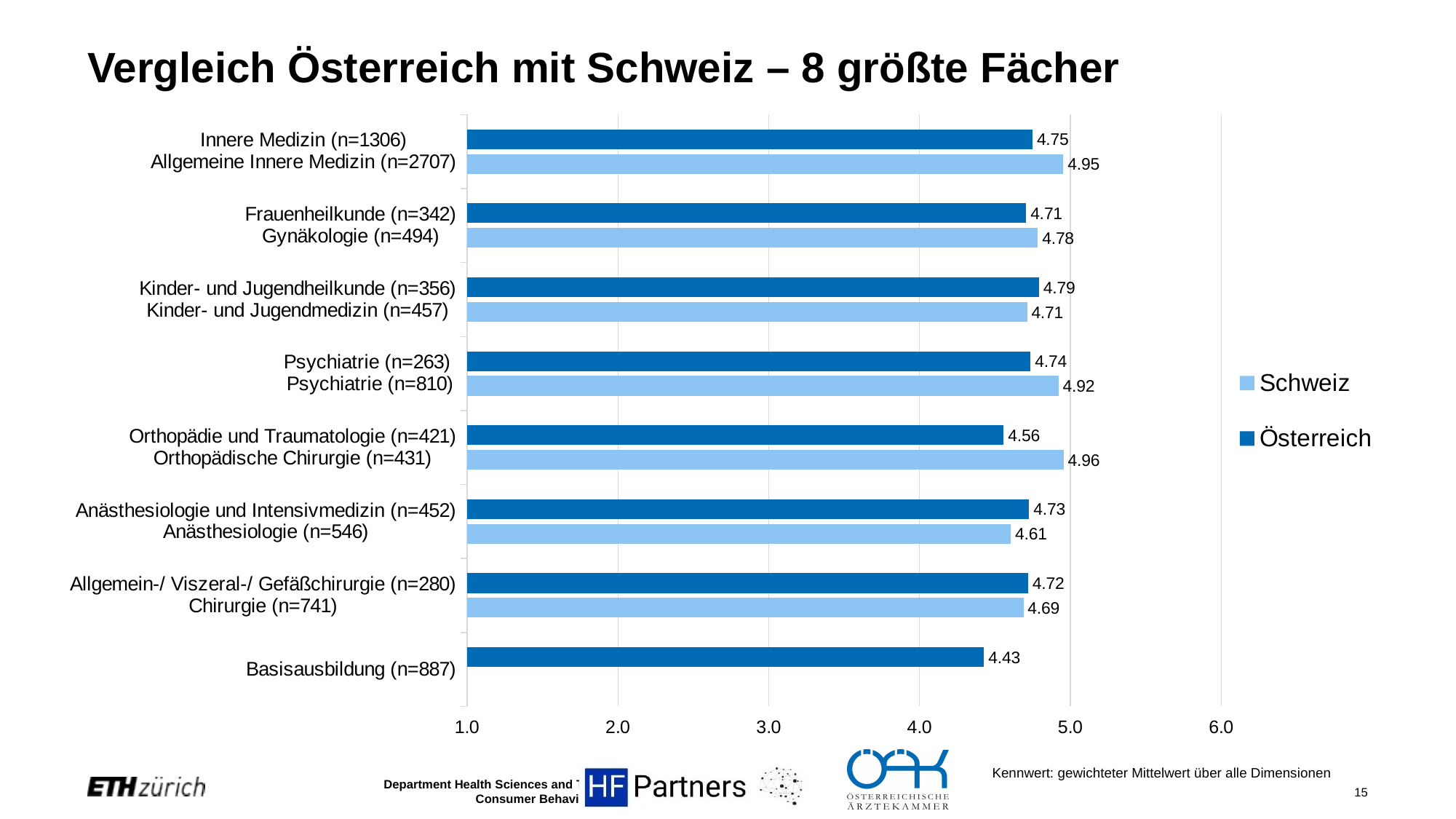
What is the value for Basisausbildung (n=887)? 4.43 Which Österreich category has the lowest value? Basisausbildung (n=887) What kind of chart is shown on the slide? Bar chart What is the value for Psychiatrie (n=810) for Schweiz? 4.92 What is the value for Innere Medizin (n=1306) for Österreich? 4.75 Which colour represents Schweiz in the legend? Light blue How many series does the legend list? 2 What is the value for Orthopädische Chirurgie (n=431) for Schweiz? 4.96 Is the value for Basisausbildung (n=887) greater or less than 5.0? less Which Schweiz category has the highest value? Orthopädische Chirurgie (n=431) Which is larger: the Österreich value for Anästhesiologie und Intensivmedizin (n=452) or the Schweiz value for Anästhesiologie (n=546)? Anästhesiologie und Intensivmedizin (n=452), Österreich What is the difference between the Schweiz value for Orthopädische Chirurgie (n=431) and the Österreich value for Orthopädie und Traumatologie (n=421)? 0.40